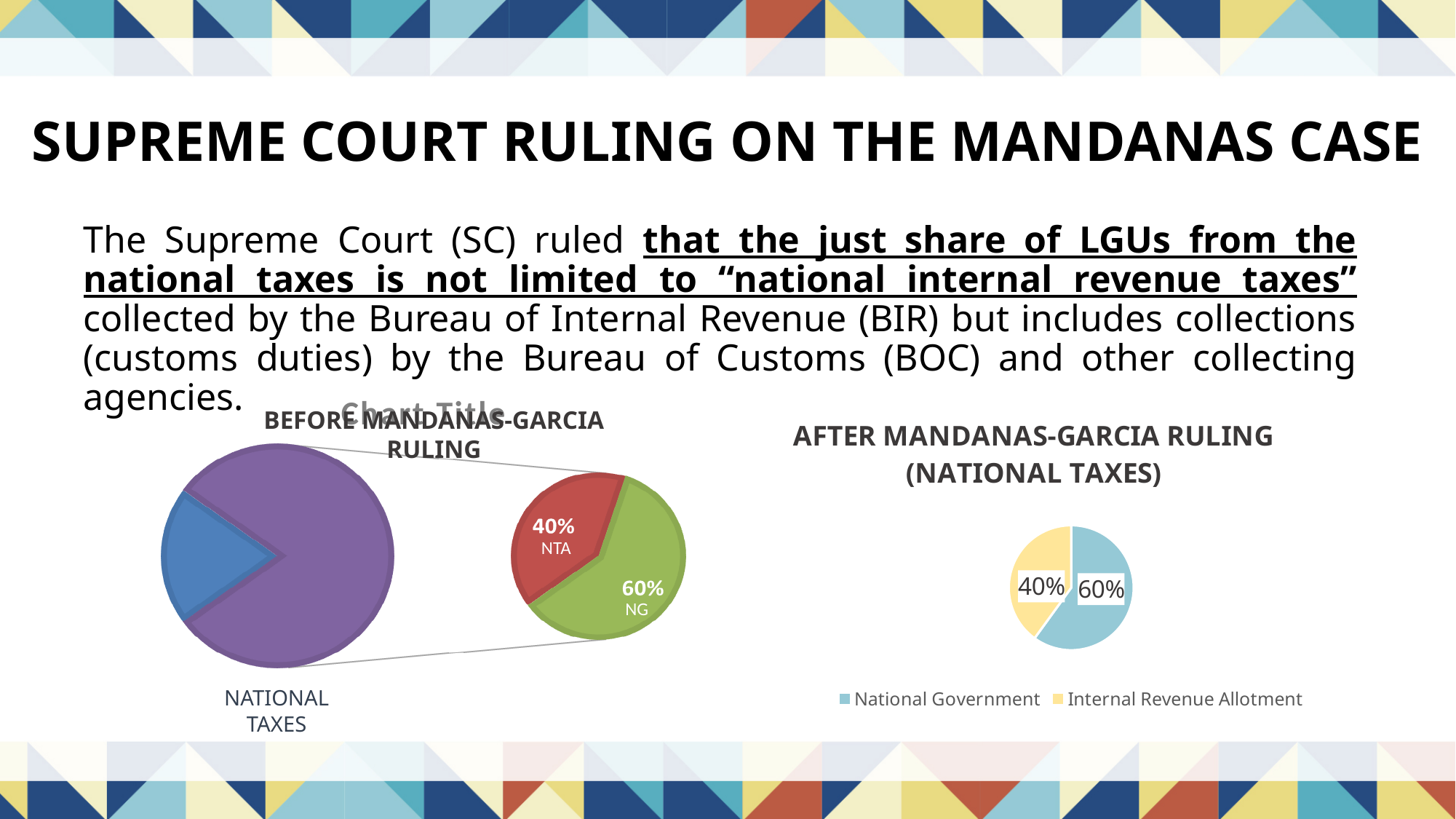
What kind of chart is the 'AFTER MANDANAS-GARCIA RULING (NATIONAL TAXES)' chart? Pie chart In the 'AFTER MANDANAS-GARCIA RULING (NATIONAL TAXES)' chart, what share does Internal Revenue Allotment have? 40% In the 'BEFORE MANDANAS-GARCIA RULING' chart, what share is labelled NTA? 40% How many entries does the legend of the 'AFTER MANDANAS-GARCIA RULING (NATIONAL TAXES)' chart list? 2 In the 'BEFORE MANDANAS-GARCIA RULING' chart, what share is labelled NG? 60% In the 'AFTER MANDANAS-GARCIA RULING (NATIONAL TAXES)' chart, which slice is larger, National Government or Internal Revenue Allotment? National Government In the 'BEFORE MANDANAS-GARCIA RULING' chart, which slice of the smaller pie is larger, NTA or NG? NG In the 'BEFORE MANDANAS-GARCIA RULING' chart, what is the difference between the NG share and the NTA share? 20% In the 'AFTER MANDANAS-GARCIA RULING (NATIONAL TAXES)' chart, what share does National Government have? 60% What is the category label shown below the large pie in the 'BEFORE MANDANAS-GARCIA RULING' chart? NATIONAL TAXES In the 'AFTER MANDANAS-GARCIA RULING (NATIONAL TAXES)' chart, what is the difference between the National Government share and the Internal Revenue Allotment share? 20% In the 'AFTER MANDANAS-GARCIA RULING (NATIONAL TAXES)' chart, what colour is the Internal Revenue Allotment slice? Yellow